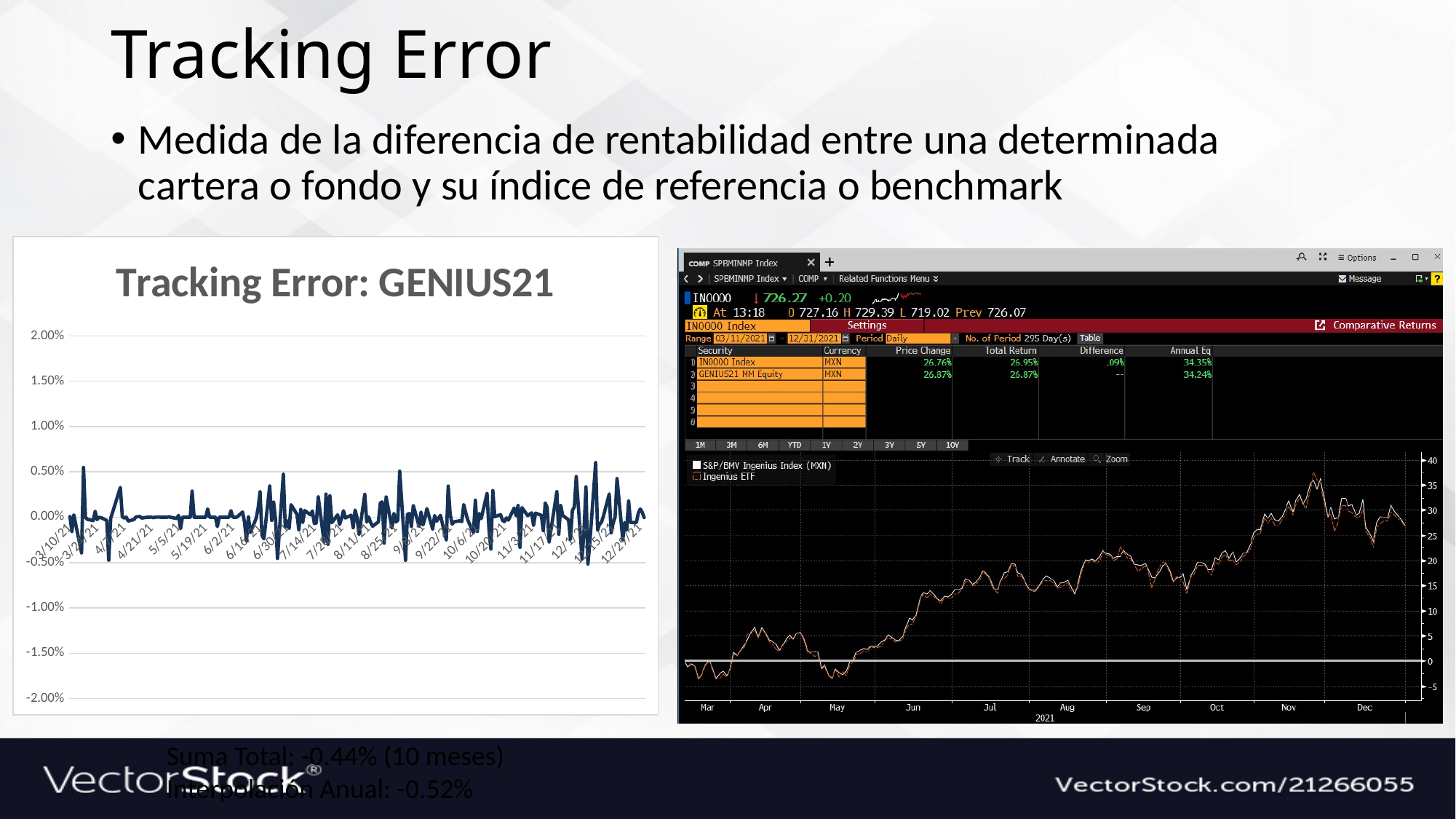
On the left chart "Tracking Error: GENIUS21", is the highest plotted value greater or less than 1.00%? less On the left chart "Tracking Error: GENIUS21", is the lowest plotted value greater or less than -1.00%? greater What is the title of the left chart? Tracking Error: GENIUS21 What kind of chart is the left chart titled "Tracking Error: GENIUS21"? line chart On the right Bloomberg chart, what are the two series named in the legend? S&P/BMV Ingenius Index (MXN) and Ingenius ETF On the right Bloomberg chart, is the peak value reached around Nov greater or less than 35? greater On the right Bloomberg chart, do the plotted values generally rise or fall from Mar to Dec 2021? rise On the left chart "Tracking Error: GENIUS21", what is the highest value shown on the vertical axis? 2.00% In the table on the right Bloomberg screen, what is the Annual Eq value for GENIUS21 MM Equity? 34.24% On the right Bloomberg chart, how many series does the legend list? 2 In the table on the right Bloomberg screen, which has the higher Annual Eq value, IN0000 Index or GENIUS21 MM Equity? IN0000 Index In the table on the right Bloomberg screen, what is the Total Return for IN0000 Index? 26.95%